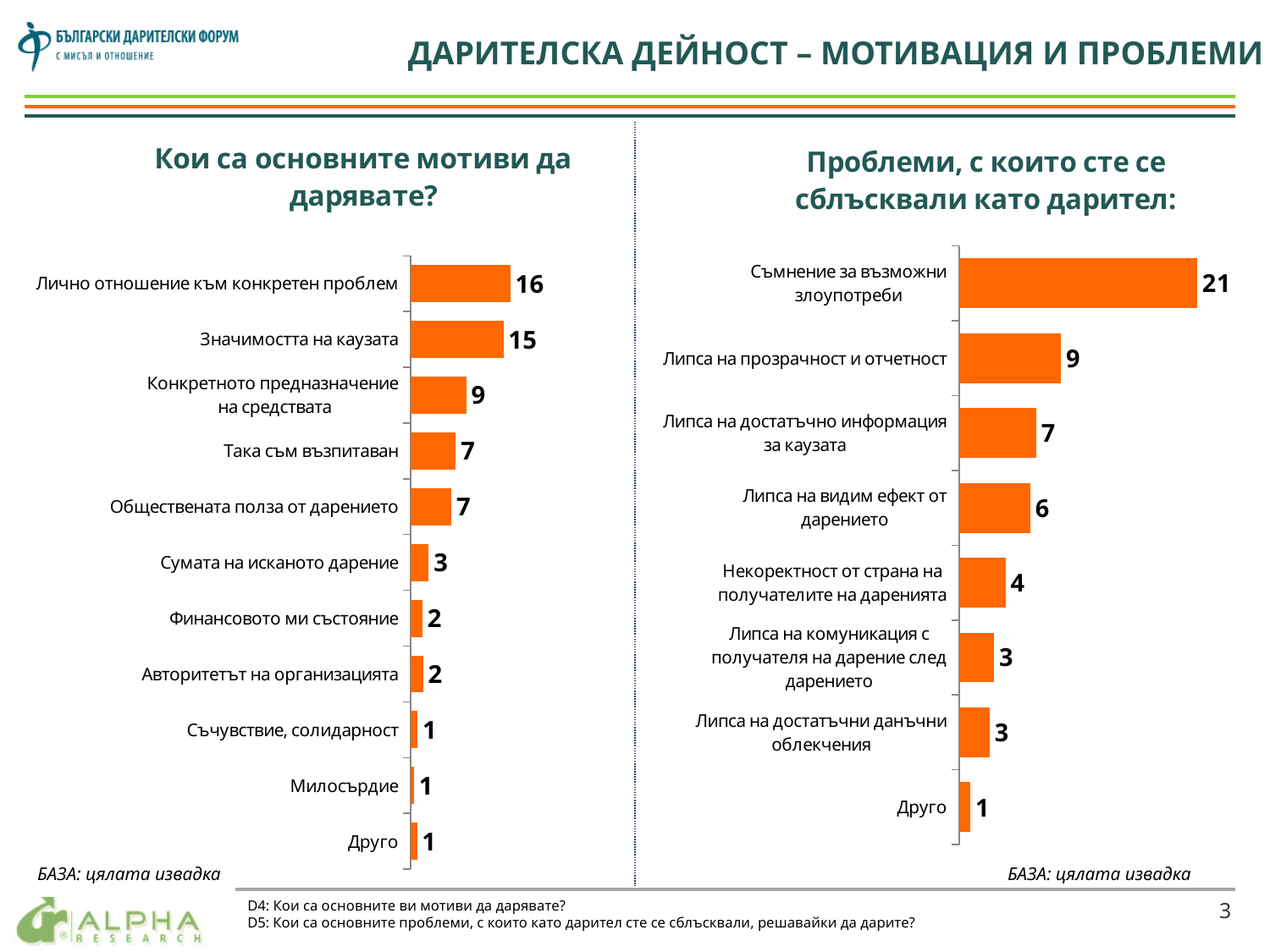
In the left chart 'Кои са основните мотиви да дарявате?', how many categories are shown? 11 In the right chart 'Проблеми, с които сте се сблъсквали като дарител', what is the value for 'Съмнение за възможни злоупотреби'? 21 In the right chart 'Проблеми, с които сте се сблъсквали като дарител', how many categories are shown? 8 In the right chart 'Проблеми, с които сте се сблъсквали като дарител', what is the value for 'Липса на видим ефект от дарението'? 6 In the left chart 'Кои са основните мотиви да дарявате?', which category has the highest value? Лично отношение към конкретен проблем In the left chart 'Кои са основните мотиви да дарявате?', what is the value for 'Лично отношение към конкретен проблем'? 16 What type of chart is used on the left side of the slide? Bar chart In the right chart 'Проблеми, с които сте се сблъсквали като дарител', what is the difference between 'Съмнение за възможни злоупотреби' and 'Липса на прозрачност и отчетност'? 12 In the left chart 'Кои са основните мотиви да дарявате?', which is larger: 'Сумата на исканото дарение' or 'Финансовото ми състояние'? Сумата на исканото дарение In the left chart 'Кои са основните мотиви да дарявате?', what is the value for 'Конкретното предназначение на средствата'? 9 In the right chart 'Проблеми, с които сте се сблъсквали като дарител', which category has the lowest value? Друго In the left chart 'Кои са основните мотиви да дарявате?', what is the difference between 'Значимостта на каузата' and 'Така съм възпитаван'? 8